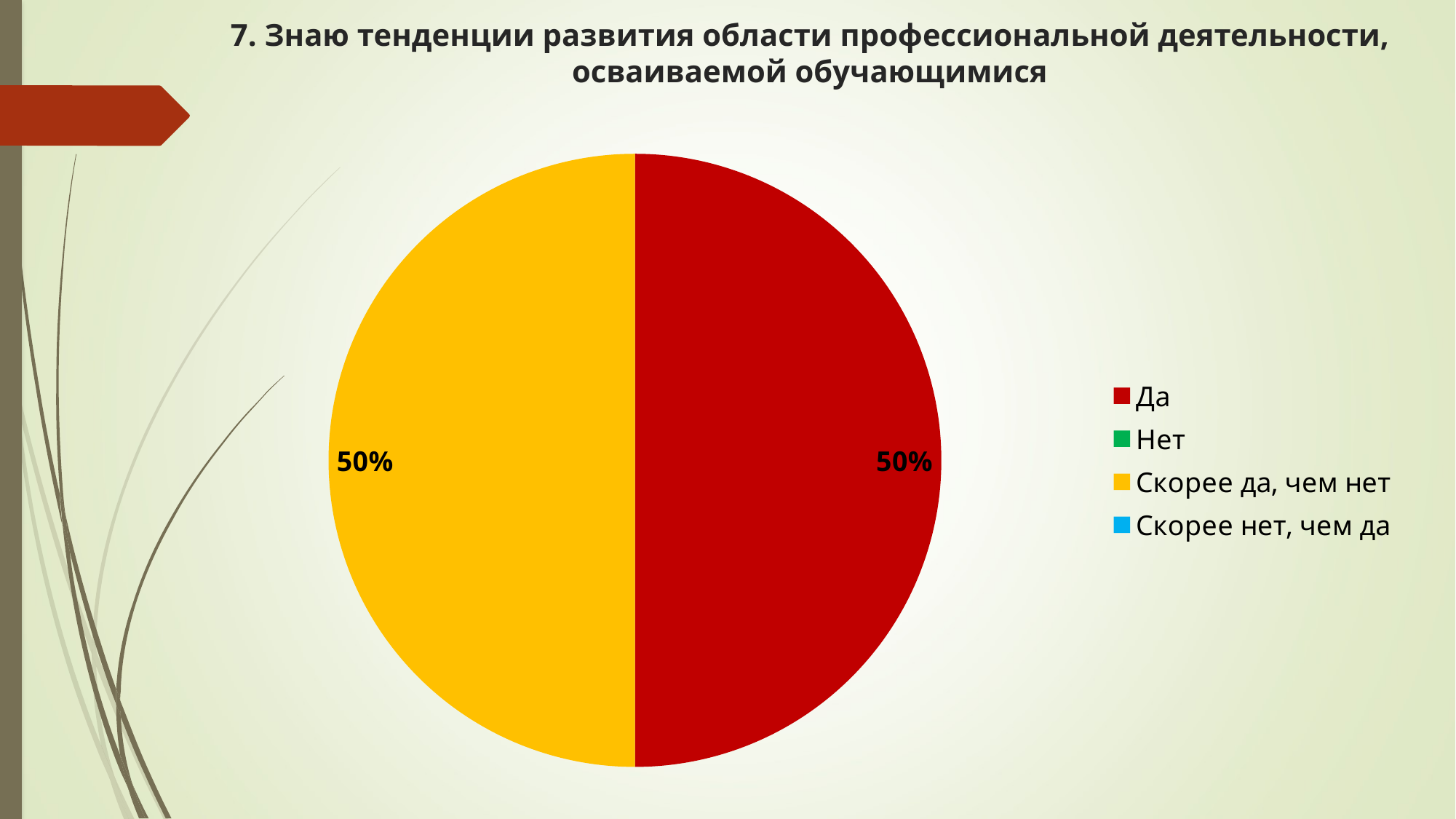
What is the combined share of "Да" and "Скорее да, чем нет"? 100% What share of the pie does "Скорее да, чем нет" take? 50% What is the difference between the shares of "Да" and "Скорее да, чем нет"? 0% What kind of chart is shown on the slide? pie chart What colour represents "Да" in the chart? red What colour represents "Скорее да, чем нет" in the chart? yellow What share of the pie does "Да" take? 50% How many slices are visible in the pie? 2 How many entries does the legend list? 4